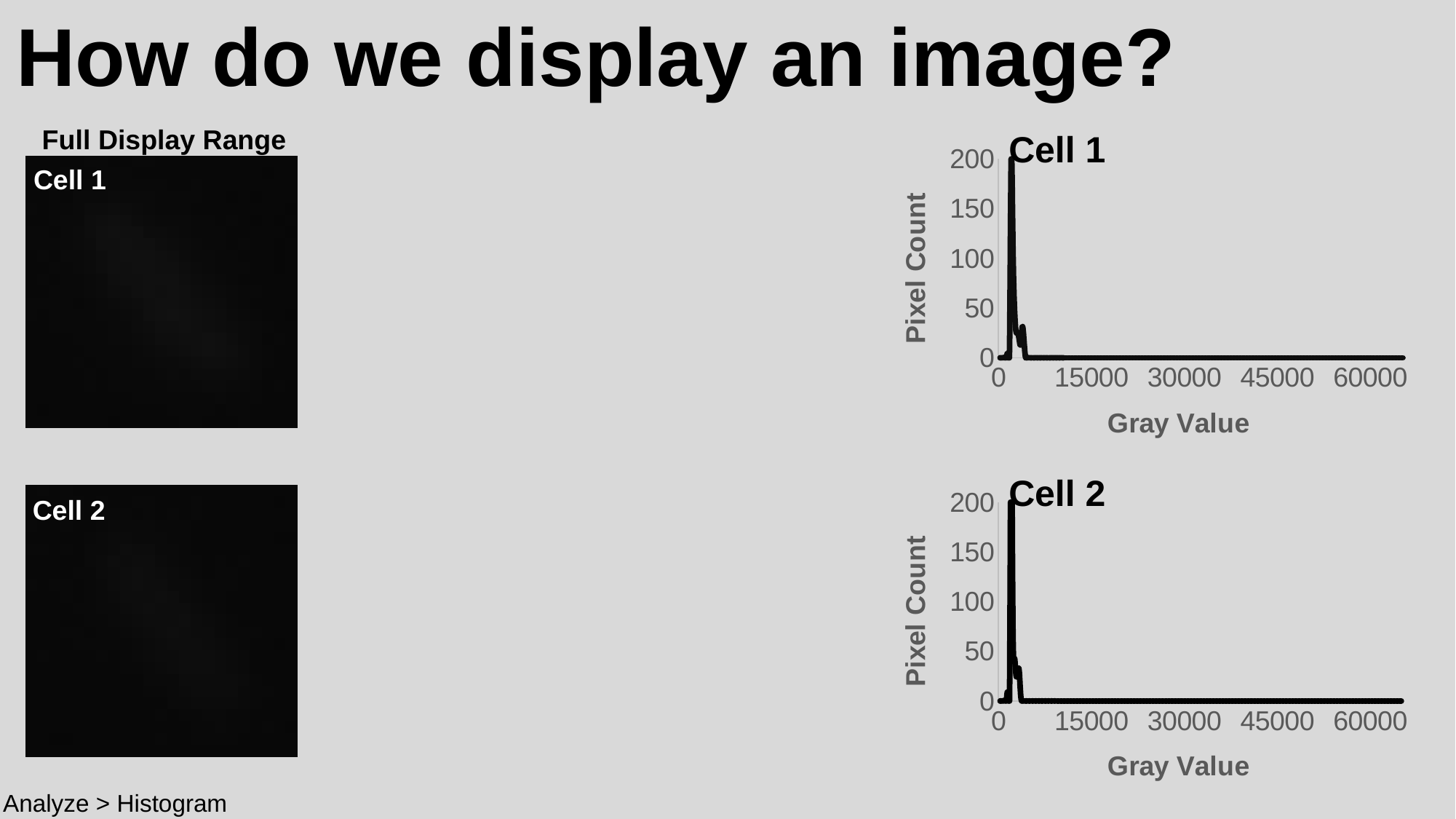
In the "Cell 1" chart, what is the highest tick value shown on the y axis? 200 In the "Cell 1" chart, does the pixel count rise or fall as the gray value increases from 15000 to 60000? It stays flat near 0 What kind of chart is the "Cell 1" chart on the right of the slide? line chart In the "Cell 2" chart, what is the label of the y axis? Pixel Count In the "Cell 2" chart, is the pixel count at a gray value of 45000 greater or less than 50? less In the "Cell 1" chart, what is the label of the x axis? Gray Value What kind of chart is the "Cell 2" chart on the right of the slide? line chart In the "Cell 2" chart, is the peak pixel count greater or less than 150? greater How many charts are shown on the slide? 2 In the "Cell 1" chart, is the pixel count at a gray value of 30000 greater or less than 50? less